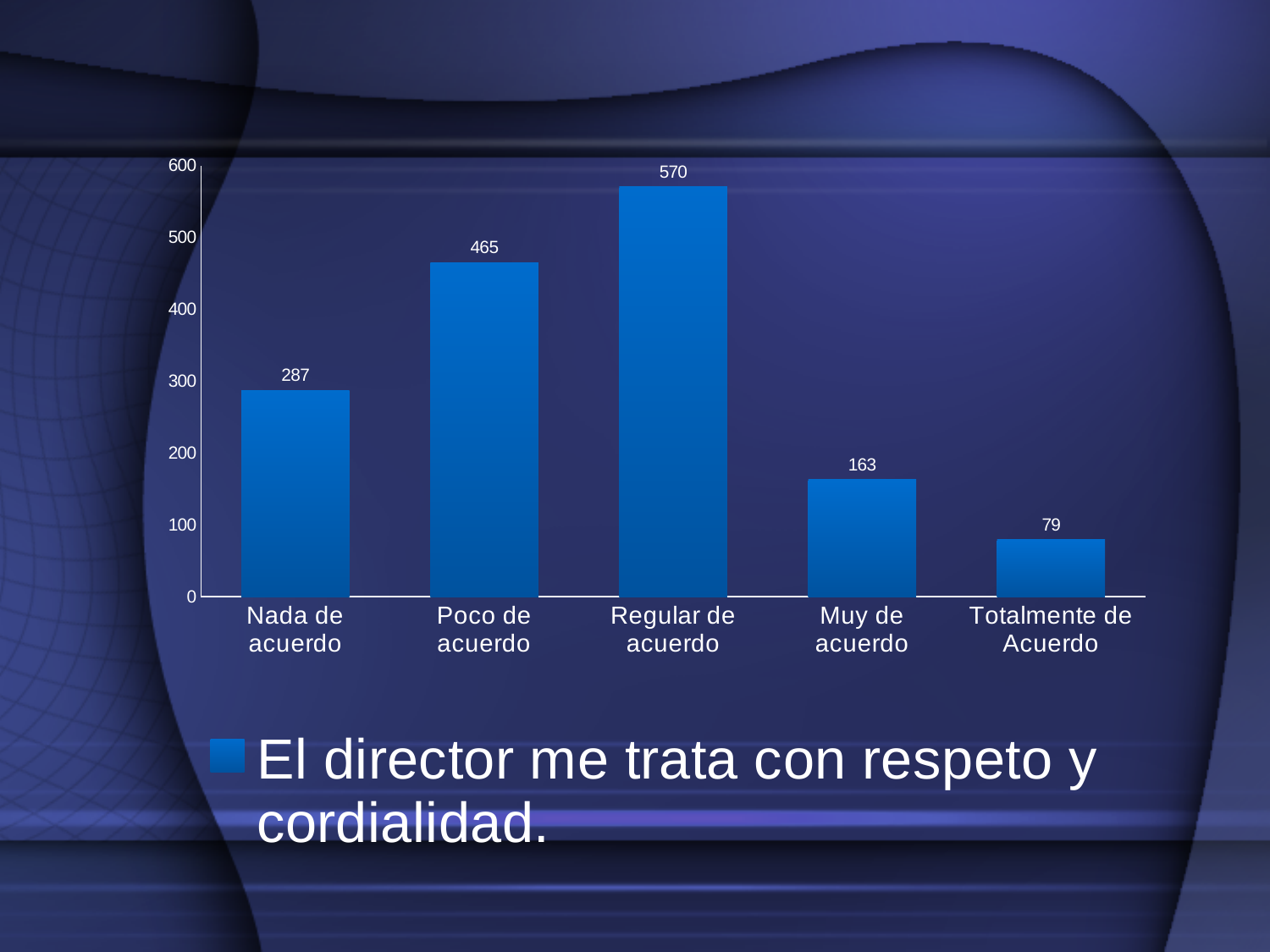
How many categories are shown on the x axis? 5 What is the difference between the values for "Nada de acuerdo" and "Muy de acuerdo"? 124 What kind of chart is shown on the slide? bar chart Is the value for "Muy de acuerdo" greater or less than 200? less What is the difference between the values for "Regular de acuerdo" and "Poco de acuerdo"? 105 What is the value for "Nada de acuerdo"? 287 Which is larger, the value for "Poco de acuerdo" or the value for "Nada de acuerdo"? Poco de acuerdo Which category has the highest value? Regular de acuerdo What is the highest value shown on the y axis? 600 What is the value for "Totalmente de Acuerdo"? 79 Which category has the lowest value? Totalmente de Acuerdo What is the value for "Regular de acuerdo"? 570